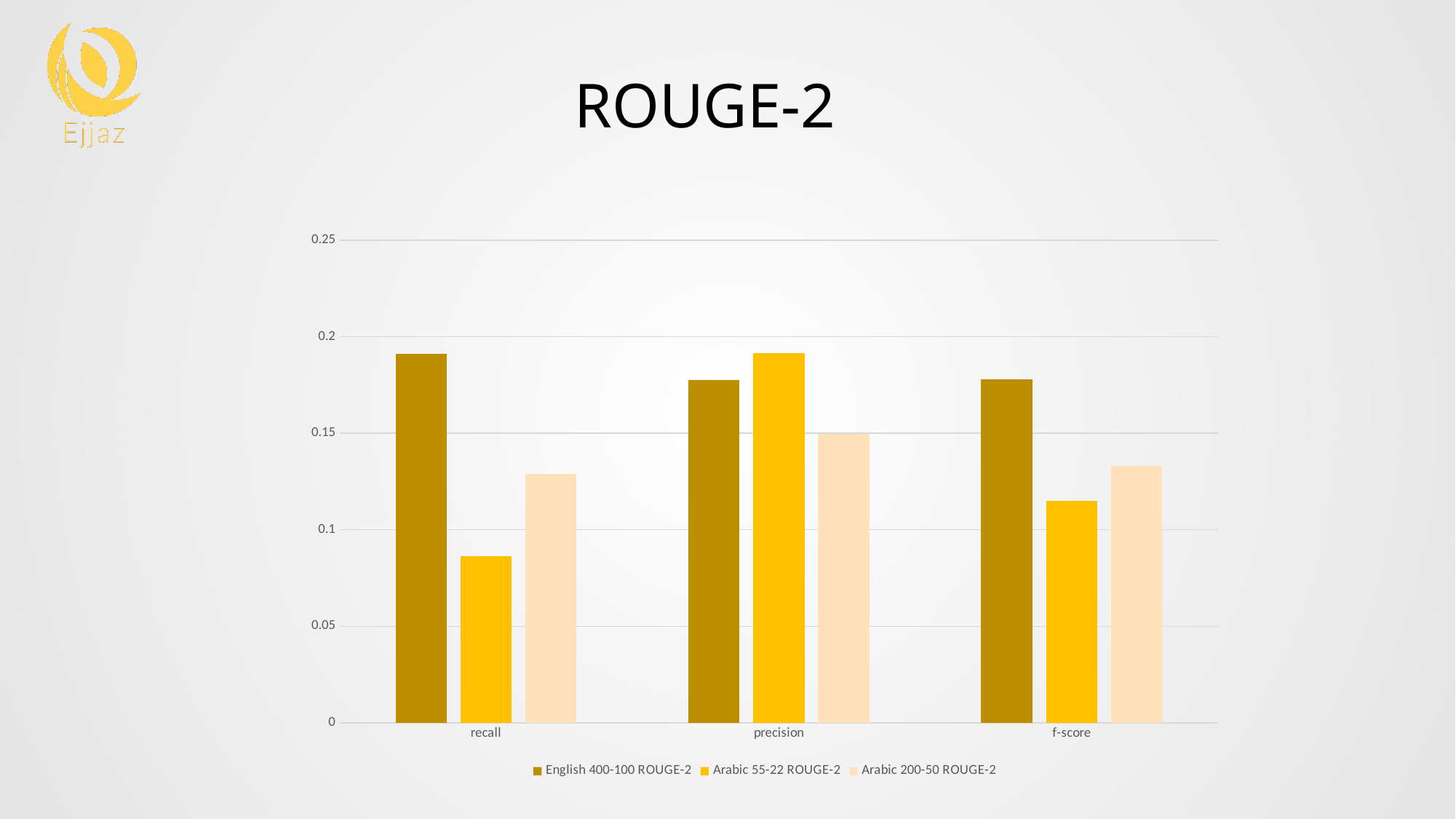
Is the recall value for Arabic 55-22 ROUGE-2 greater or less than 0.1? less Which series has the lowest recall value? Arabic 55-22 ROUGE-2 What kind of chart is shown on the slide? bar chart How many categories are shown on the x axis of the chart? 3 For f-score, which is larger: Arabic 55-22 ROUGE-2 or Arabic 200-50 ROUGE-2? Arabic 200-50 ROUGE-2 For precision, which is larger: English 400-100 ROUGE-2 or Arabic 55-22 ROUGE-2? Arabic 55-22 ROUGE-2 Which series has the highest f-score value? English 400-100 ROUGE-2 How many series does the legend list? 3 Is the f-score value for Arabic 55-22 ROUGE-2 greater or less than 0.15? less Is the recall value for English 400-100 ROUGE-2 greater or less than 0.15? greater What is the title of the chart? ROUGE-2